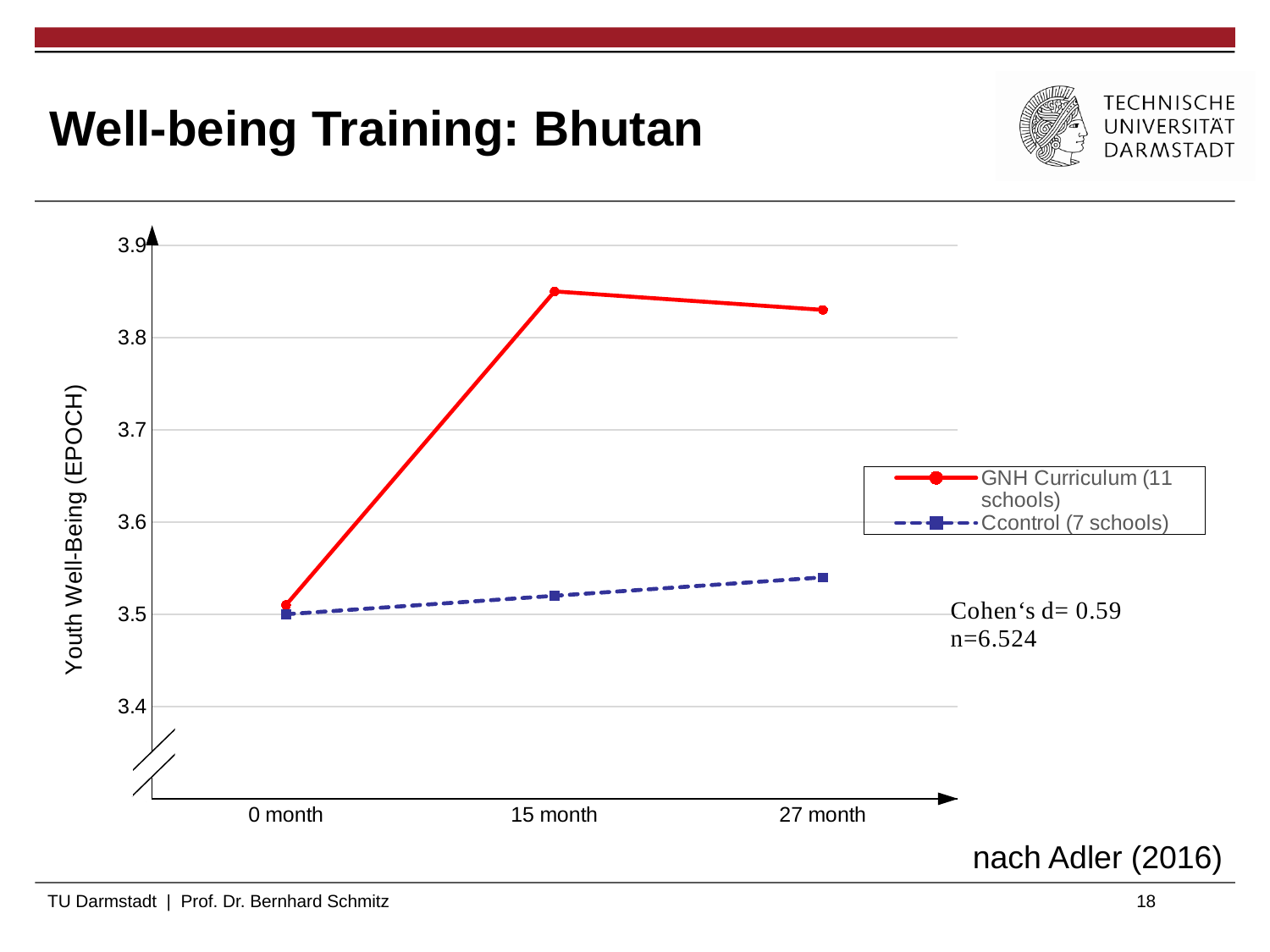
At which time point does the GNH Curriculum (11 schools) series reach its highest value? 15 month Is the value for GNH Curriculum (11 schools) at 0 month greater or less than 3.6? less Is the value for Ccontrol (7 schools) at 27 month greater or less than 3.6? less How many time points are shown on the x axis? 3 What is the label of the y axis? Youth Well-Being (EPOCH) Does the Ccontrol (7 schools) series rise or fall from 0 month to 27 month? rise At which time point does the Ccontrol (7 schools) series have its lowest value? 0 month How many series does the legend list? 2 What kind of chart is shown on the slide? line chart Which series is drawn with a dashed line? Ccontrol (7 schools) Is the value for GNH Curriculum (11 schools) at 15 month greater or less than 3.8? greater At 27 month, which series has the larger value, GNH Curriculum (11 schools) or Ccontrol (7 schools)? GNH Curriculum (11 schools)